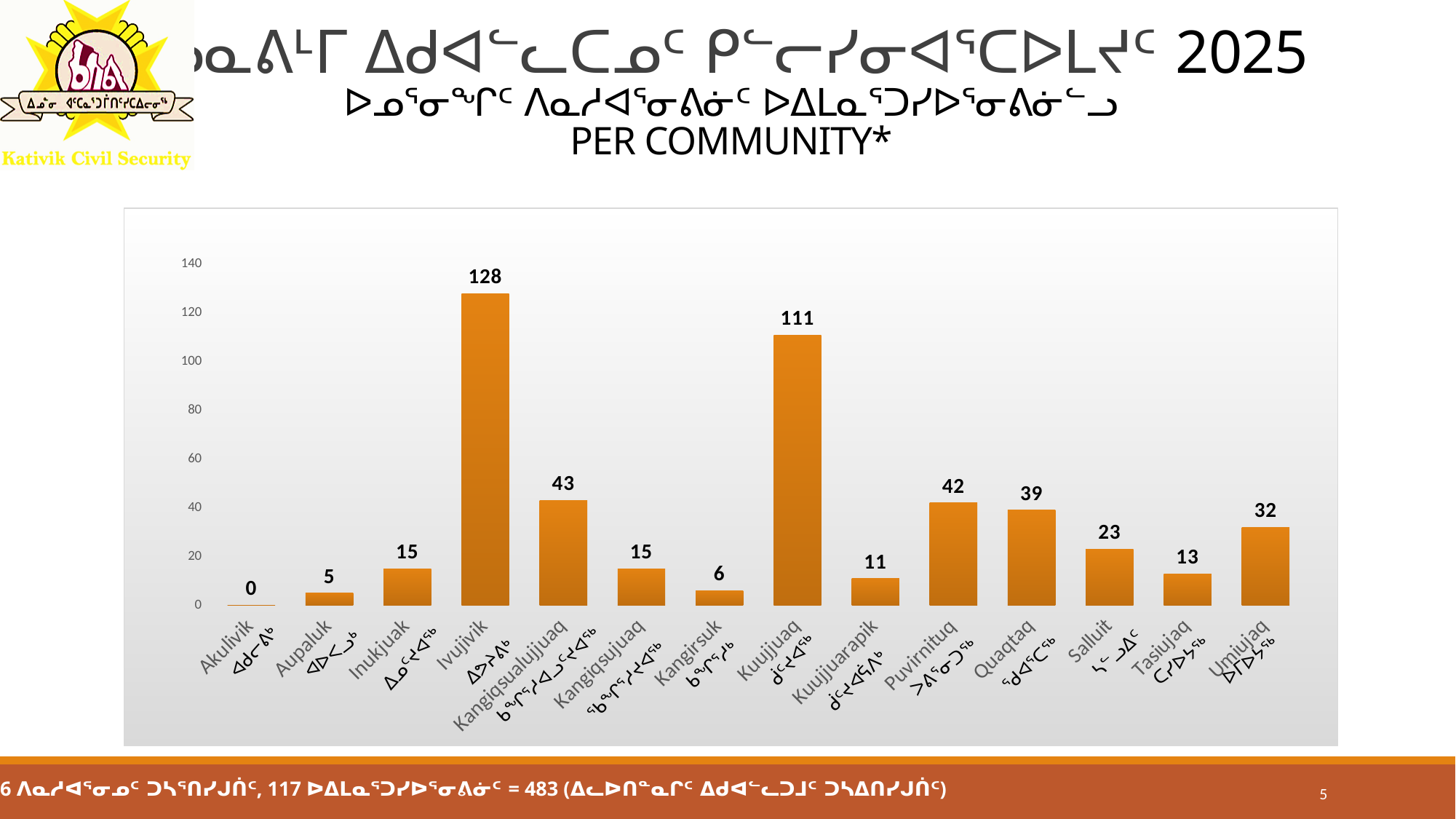
What kind of chart is shown on the slide? bar chart Which is larger, the value for Quaqtaq or the value for Umiujaq? Quaqtaq What is the value for Kuujjuaq? 111 What is the value for Salluit? 23 Which community has the lowest value? Akulivik What is the difference between the values for Puvirnituq and Tasiujaq? 29 What is the value for Ivujivik? 128 Is the value for Kangiqsualujjuaq greater or less than 40? greater What is the value for Akulivik? 0 Which community has the highest value? Ivujivik How many communities are shown on the x axis? 14 What is the difference between the values for Ivujivik and Kuujjuaq? 17